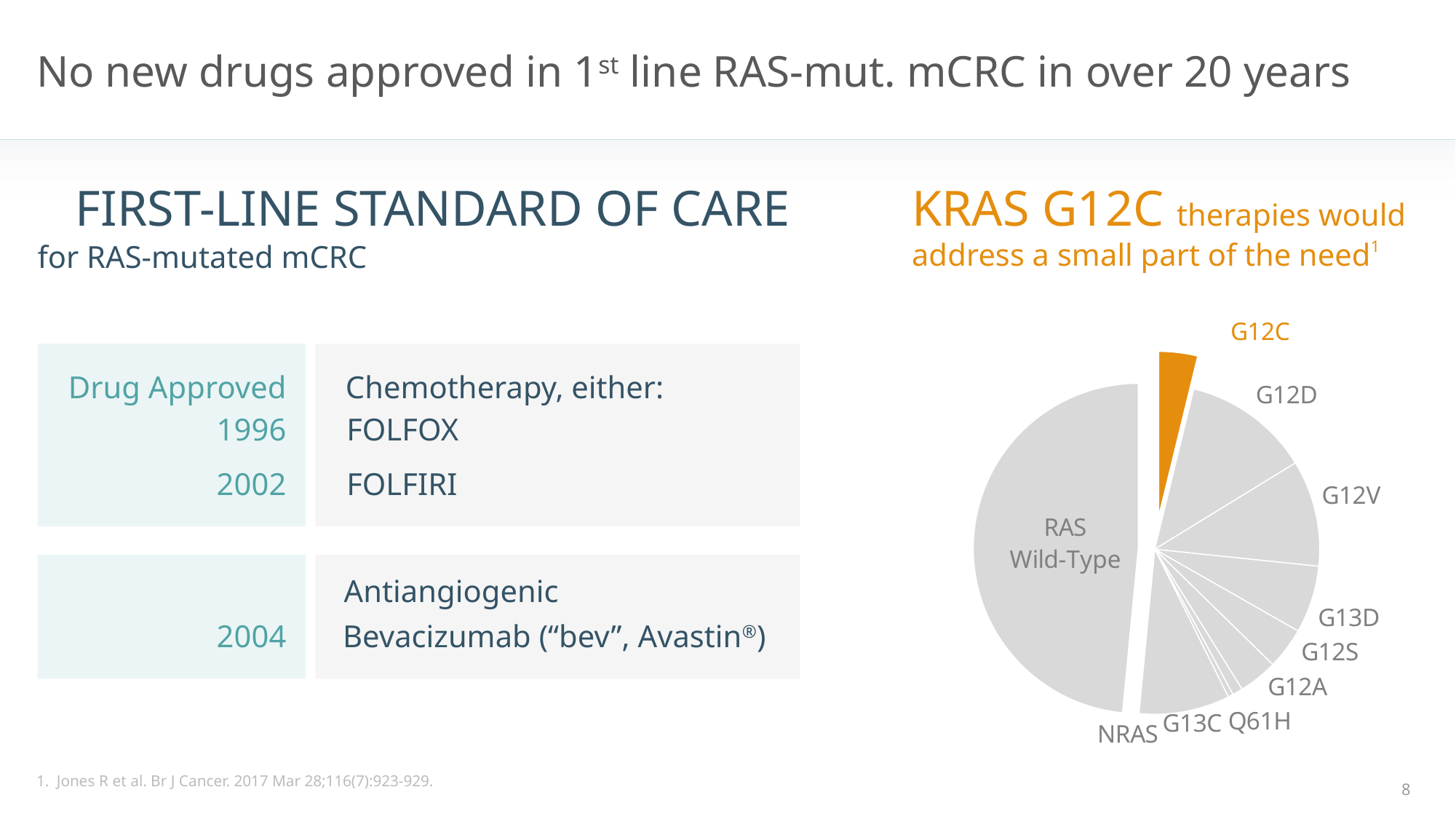
Which is larger in the pie chart, the G12V slice or the G12C slice? G12V How many labeled slices does the pie chart have? 10 What kind of chart is shown on the right side of the slide? pie chart Which slice of the pie chart is highlighted in orange? G12C Which slice of the pie chart is the largest? RAS Wild-Type What is the heading above the pie chart? KRAS G12C therapies would address a small part of the need Which is larger in the pie chart, the G12D slice or the G12C slice? G12D Which is larger in the pie chart, the RAS Wild-Type slice or the G12C slice? RAS Wild-Type